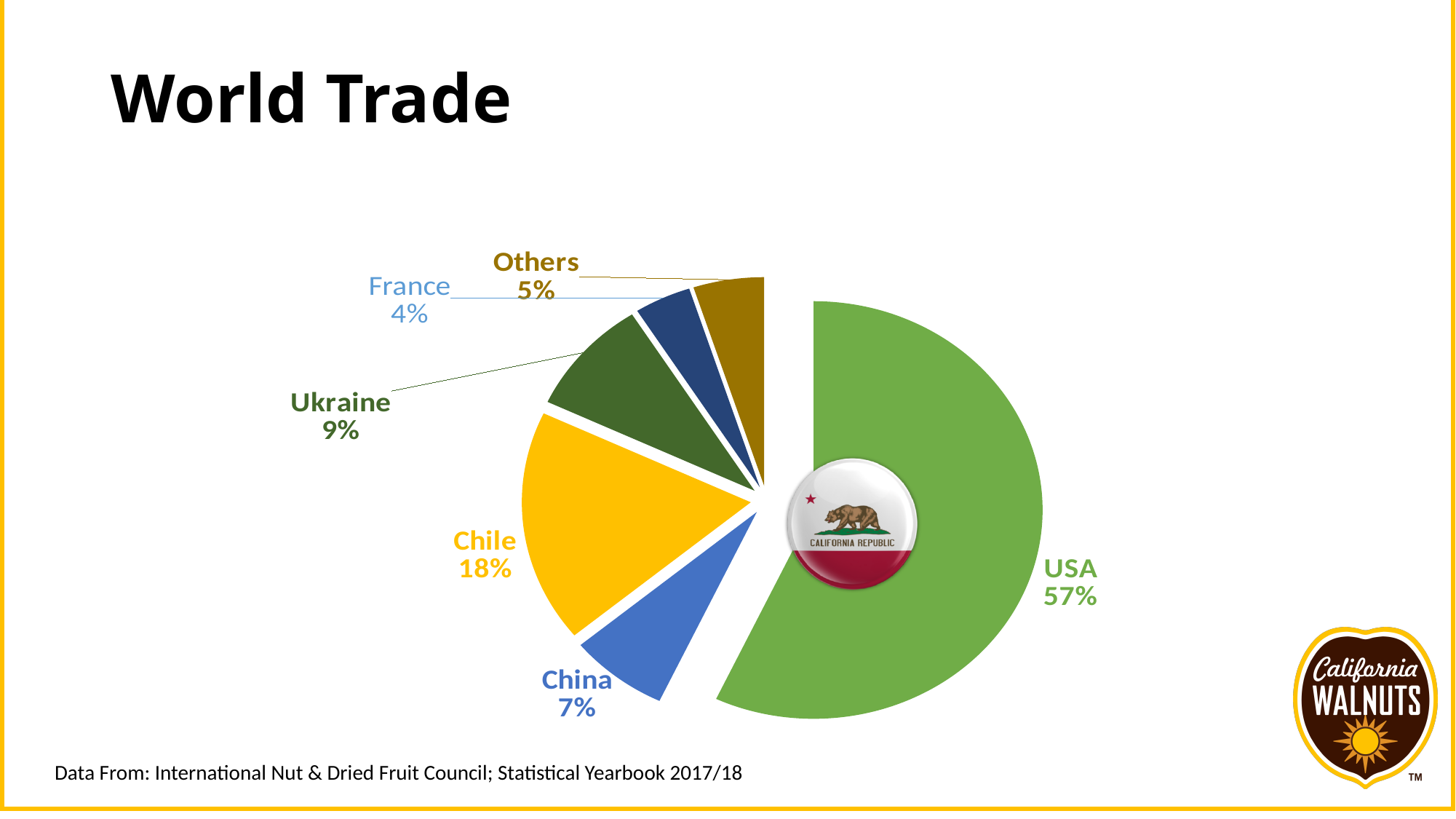
How many slices does the pie chart have? 6 What share of world trade does the USA hold? 57% What share of world trade does China hold? 7% Which has a larger share of world trade, Ukraine or China? Ukraine What is the difference between the USA's share and Chile's share? 39% What share of world trade does Ukraine hold? 9% What share of world trade does Chile hold? 18% What share of world trade does France hold? 4% Which country has the largest share of world trade? USA What is the title of the slide? World Trade What kind of chart is shown on the slide? Pie chart Which named slice has the smallest share of world trade? France